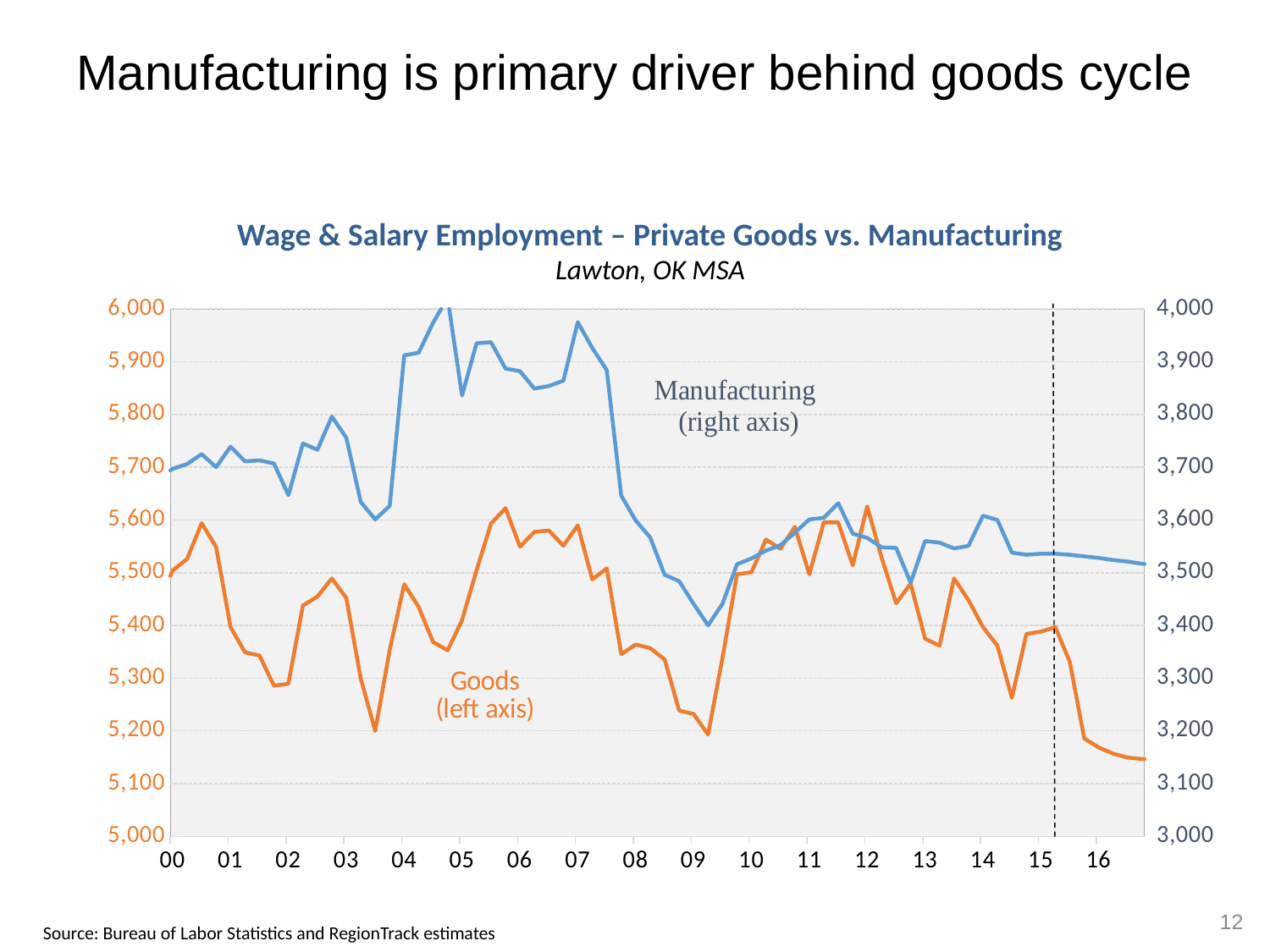
Does the Goods series rise or fall between 15 and 16? Fall Is the value for Manufacturing at 16 greater or less than 3,600? less Is the value for Goods at 16 greater or less than 5,200? less Does the Manufacturing series rise or fall between 07 and 09? Fall Is the value for Manufacturing at 09 greater or less than 3,500? less Which axis is the Goods series plotted against? Left axis What is the title of the chart? Wage & Salary Employment – Private Goods vs. Manufacturing How many data series are plotted on the chart? 2 What kind of chart is shown on the slide? Line chart